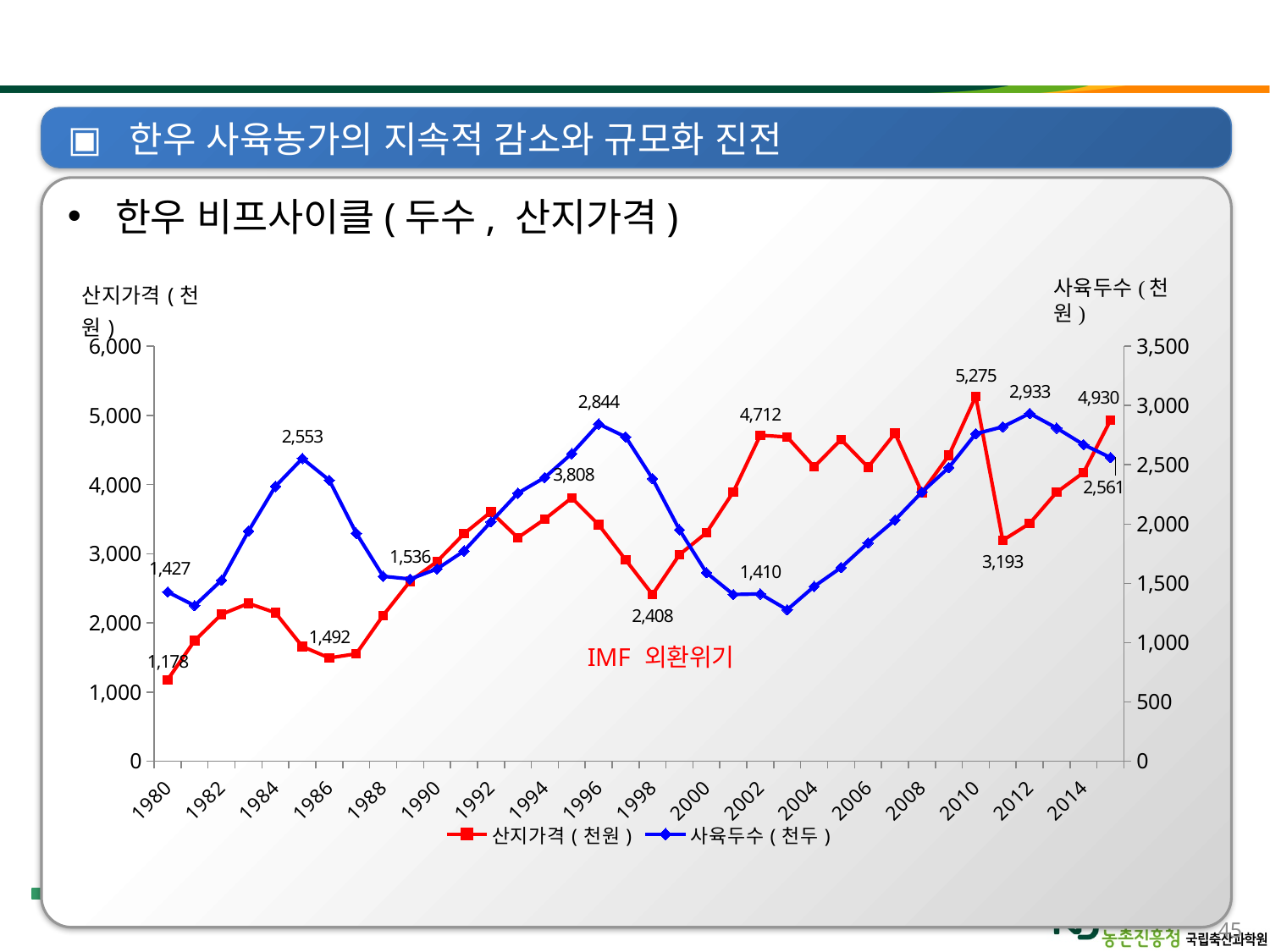
What type of chart is shown on the slide? line chart What annotation text is written in red inside the plot area? IMF 외환위기 What is the lowest labeled value of the 사육두수 (천두) series? 1,410 What is the labeled value of 산지가격 (천원) in 1980? 1,178 What is the difference between the 사육두수 labels 2,933 (2012) and 2,561 (2015)? 372 What is the labeled peak value of 사육두수 (천두) around 1996? 2,844 What is the highest labeled value of the 산지가격 (천원) series? 5,275 Is the value for 사육두수 (천두) in 2003 greater or less than 1,500 on the right axis? less What is the difference between the 산지가격 labels 5,275 (2010) and 3,193 (2011)? 2,082 What is the labeled value of 사육두수 (천두) in 1980? 1,427 How many series does the legend list? 2 Which year has the larger labeled 산지가격 value, 2002 or 1998? 2002